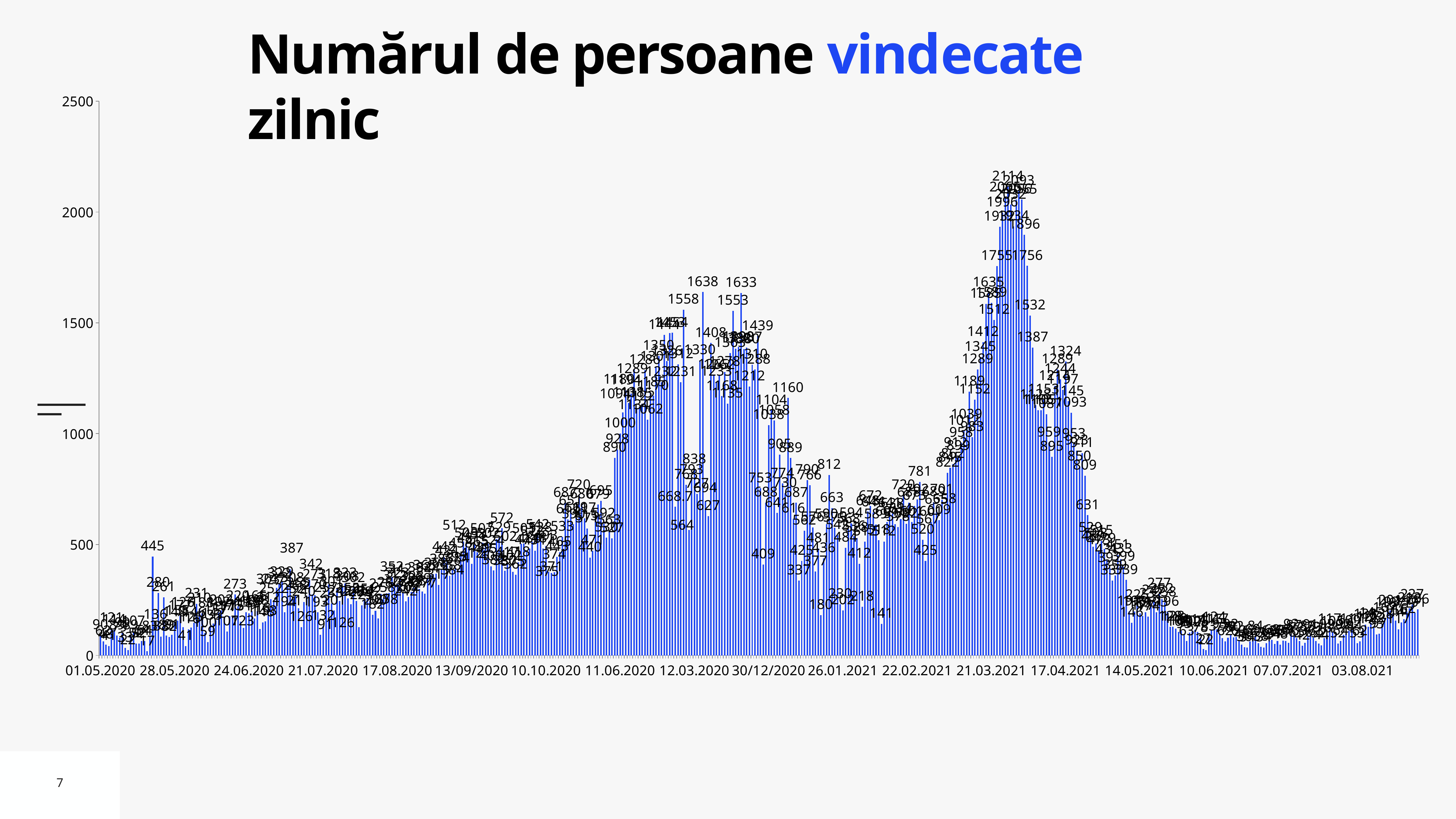
Are the values around 07.07.2021 greater or less than 500? less What is the last date label on the horizontal axis? 03.08.2021 What is the first date label on the horizontal axis? 01.05.2020 Is the tallest bar on the chart greater or less than 2000? greater Do the values rise or fall between 22.02.2021 and 21.03.2021? rise What is the highest tick value on the vertical axis? 2500 What kind of chart is shown on the slide? bar chart What is the title of the chart? Numărul de persoane vindecate zilnic Is the tallest bar on the chart located in 2020 or in 2021? 2021 What is the value of the tallest bar near 28.05.2020? 445 What is the highest data label shown on the chart? 2114 Do the values rise or fall between 17.04.2021 and 10.06.2021? fall